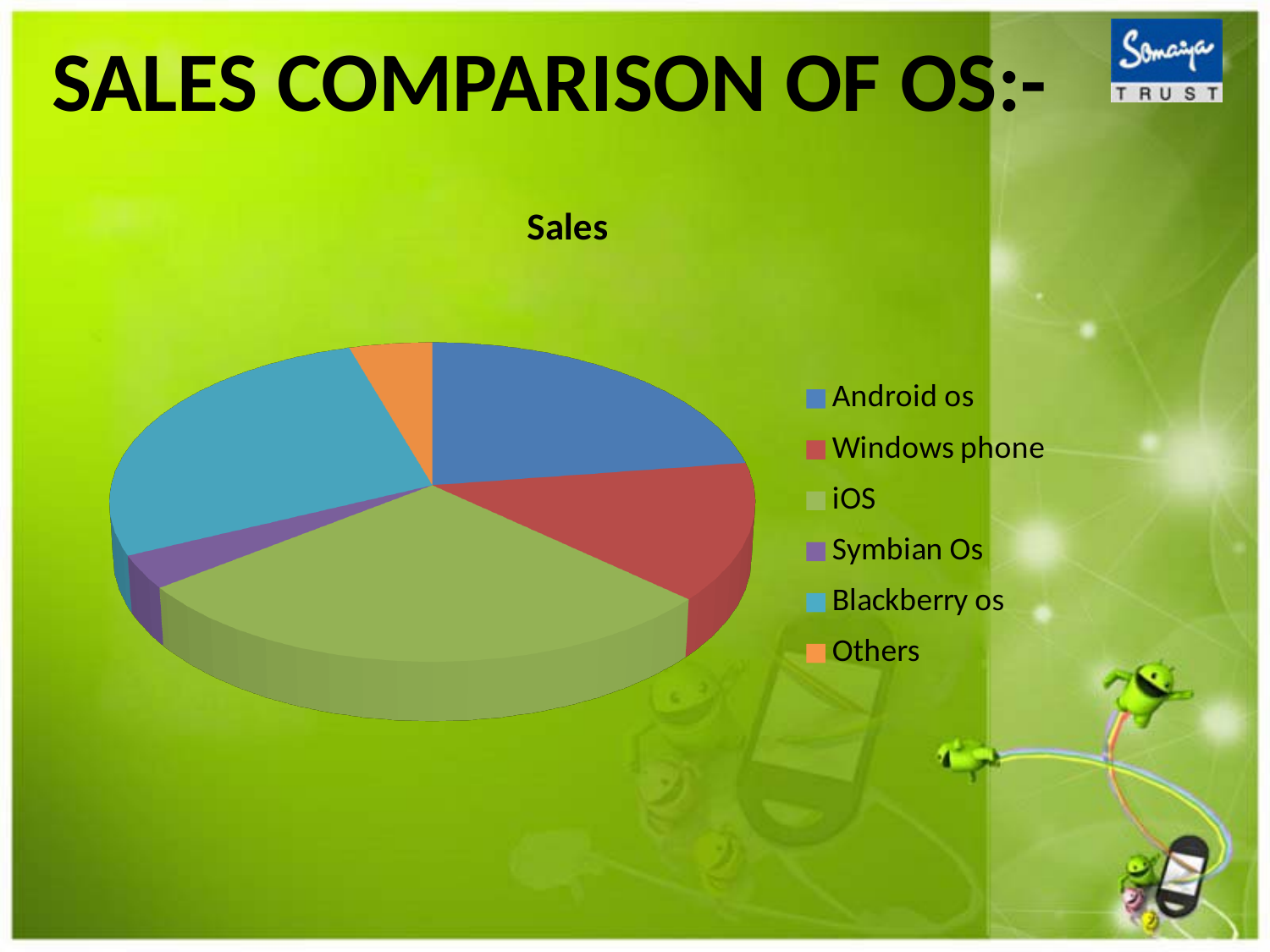
Which slice is larger, Blackberry os or Windows phone? Blackberry os Which slice is larger, iOS or Others? iOS How many entries are listed in the chart legend? 6 How many categories does the pie chart show? 6 What is the title of the chart? Sales Which category is shown in blue in the legend? Android os Which slice is larger, iOS or Windows phone? iOS What kind of chart is shown on the slide? Pie chart